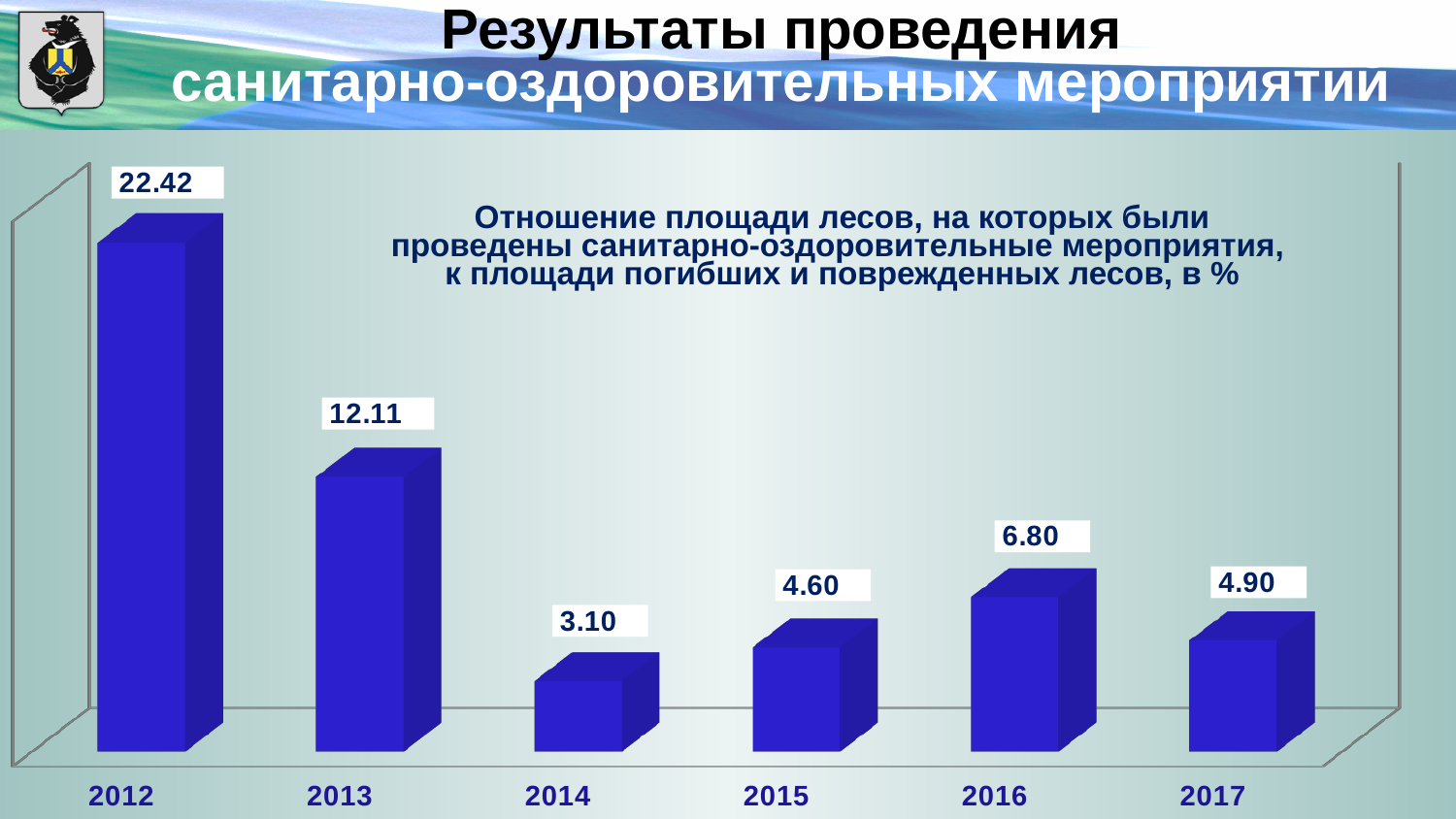
What kind of chart is shown on the slide? bar chart Which year has the highest value? 2012 What is the value for 2017? 4.90 How many years are shown on the chart? 6 Which is larger, the value for 2015 or the value for 2016? 2016 Do the values rise or fall from 2012 to 2014? fall What colour are the bars in the chart? blue What is the difference between the values for 2012 and 2013? 10.31 What is the difference between the values for 2016 and 2017? 1.90 Which year has the lowest value? 2014 What is the value for 2014? 3.10 What is the value for 2012? 22.42